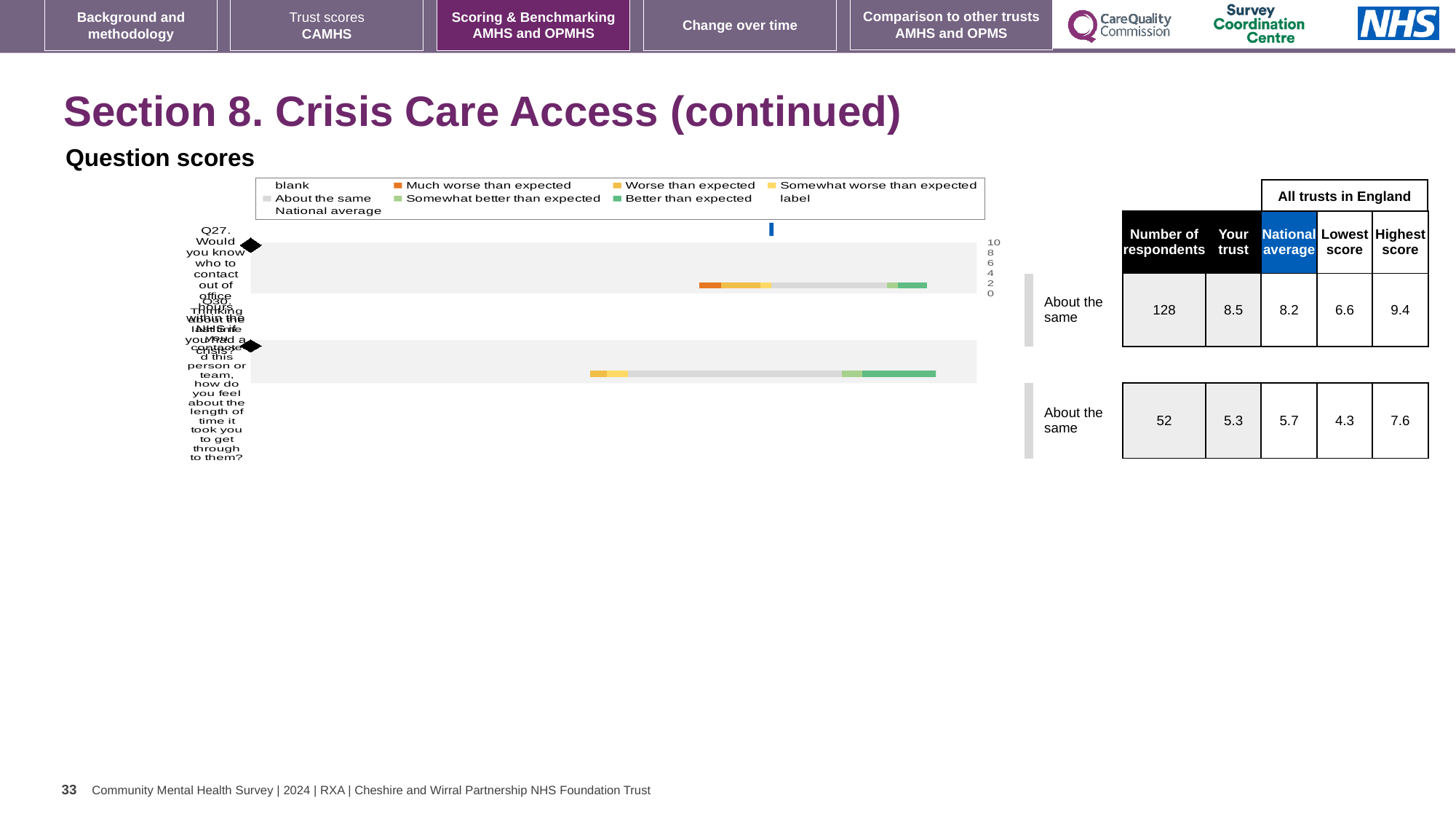
What is the lowest score among all trusts in England for Q30? 4.3 What is the difference between the highest score and the lowest score for Q27? 2.8 What is the 'Your trust' score for Q27? 8.5 What is the national average score for Q27? 8.2 By how much does the national average exceed the 'Your trust' score for Q30? 0.4 For Q27, which is larger: the 'Your trust' score or the national average? Your trust Which question has the larger number of respondents, Q27 or Q30? Q27 How many respondents are shown for Q27 in the table next to the chart? 128 What is the highest score among all trusts in England for Q30? 7.6 What kind of chart is used to show the question scores? Bar chart For Q30, which is larger: the 'Your trust' score or the national average? National average How many questions are plotted in the chart? 2